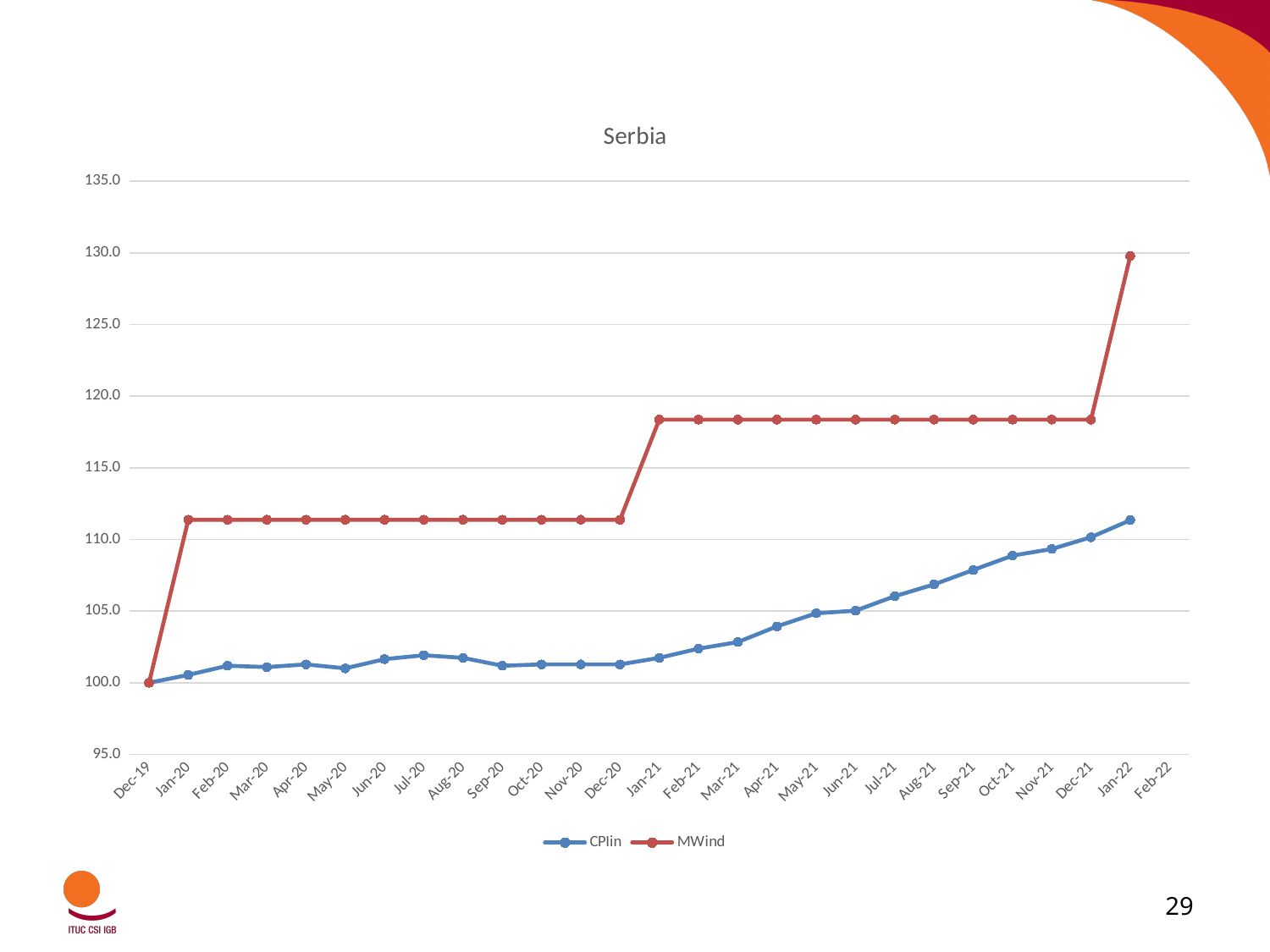
Is the value of MWind at Jun-21 greater or less than 115.0? greater Is the value of MWind at Jun-20 greater or less than 110.0? greater Does the CPIin series generally rise or fall from Dec-19 to Jan-22? rise How many series does the legend list? 2 Is the value of CPIin at Dec-20 greater or less than 105.0? less Which colour is used for the MWind series? red What is the value of CPIin at Dec-19? 100.0 At Jan-22, which series has the larger value, CPIin or MWind? MWind What kind of chart is shown on the slide? line chart What is the title of the chart? Serbia What is the value of MWind at Dec-19? 100.0